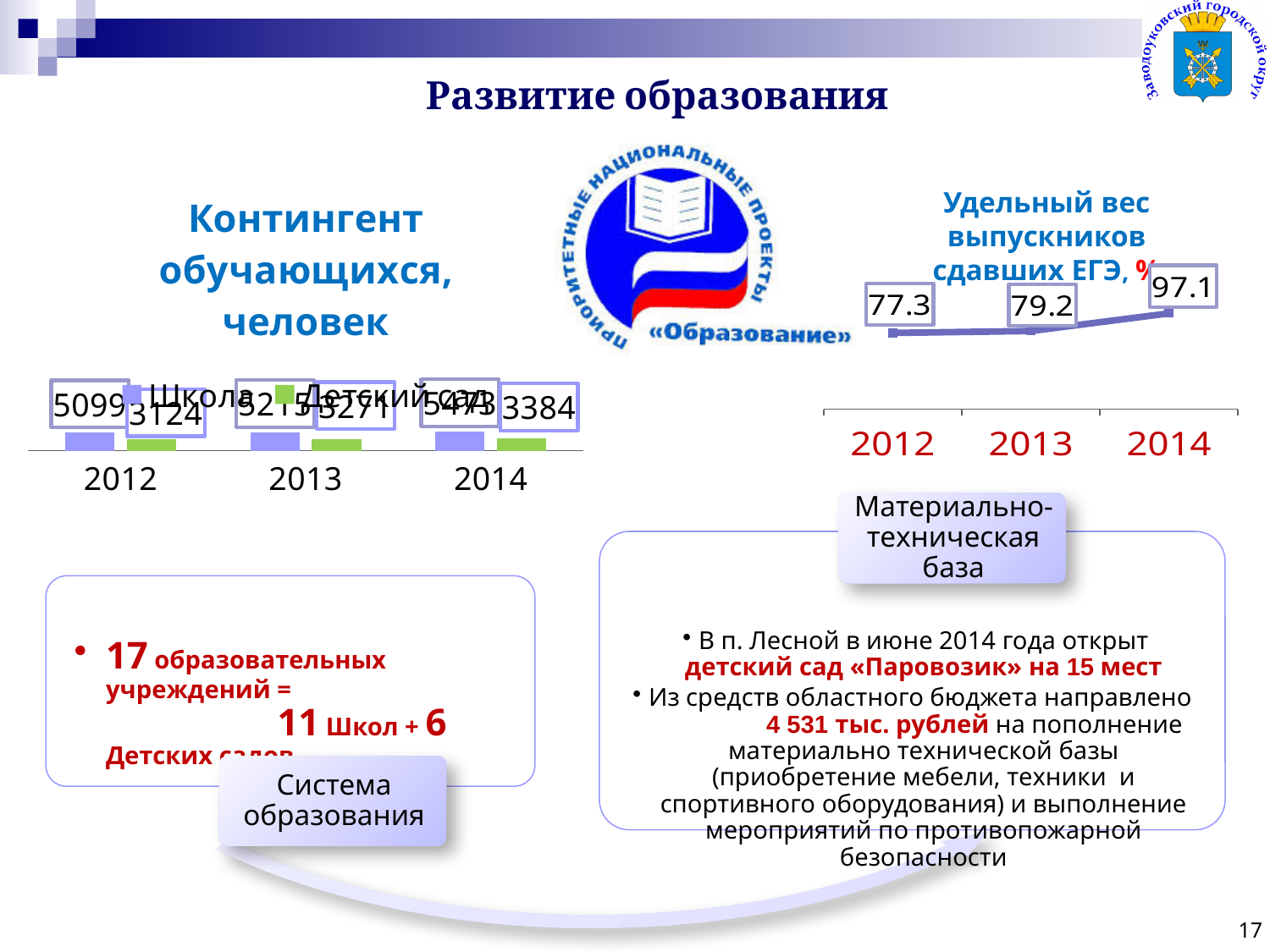
In the chart 'Контингент обучающихся, человек', what is the value for Школа in 2012? 5099 In the chart 'Удельный вес выпускников сдавших ЕГЭ, %', what is the value for 2013? 79.2 In the chart 'Удельный вес выпускников сдавших ЕГЭ, %', by how much did the value increase from 2012 to 2014? 19.8 In the chart 'Удельный вес выпускников сдавших ЕГЭ, %', do the values rise or fall from 2012 to 2014? rise In the chart 'Удельный вес выпускников сдавших ЕГЭ, %', which year has the highest value? 2014 In the chart 'Удельный вес выпускников сдавших ЕГЭ, %', what is the value for 2014? 97.1 In the chart 'Контингент обучающихся, человек', what is the value for Детский сад in 2014? 3384 In the chart 'Удельный вес выпускников сдавших ЕГЭ, %', what is the value for 2012? 77.3 In the chart 'Контингент обучающихся, человек', what is the difference between Школа and Детский сад in 2014? 2089 In the chart 'Контингент обучающихся, человек', what is the value for Детский сад in 2012? 3124 How many series does the legend of the chart 'Контингент обучающихся, человек' list? 2 What kind of chart is 'Удельный вес выпускников сдавших ЕГЭ, %'? line chart